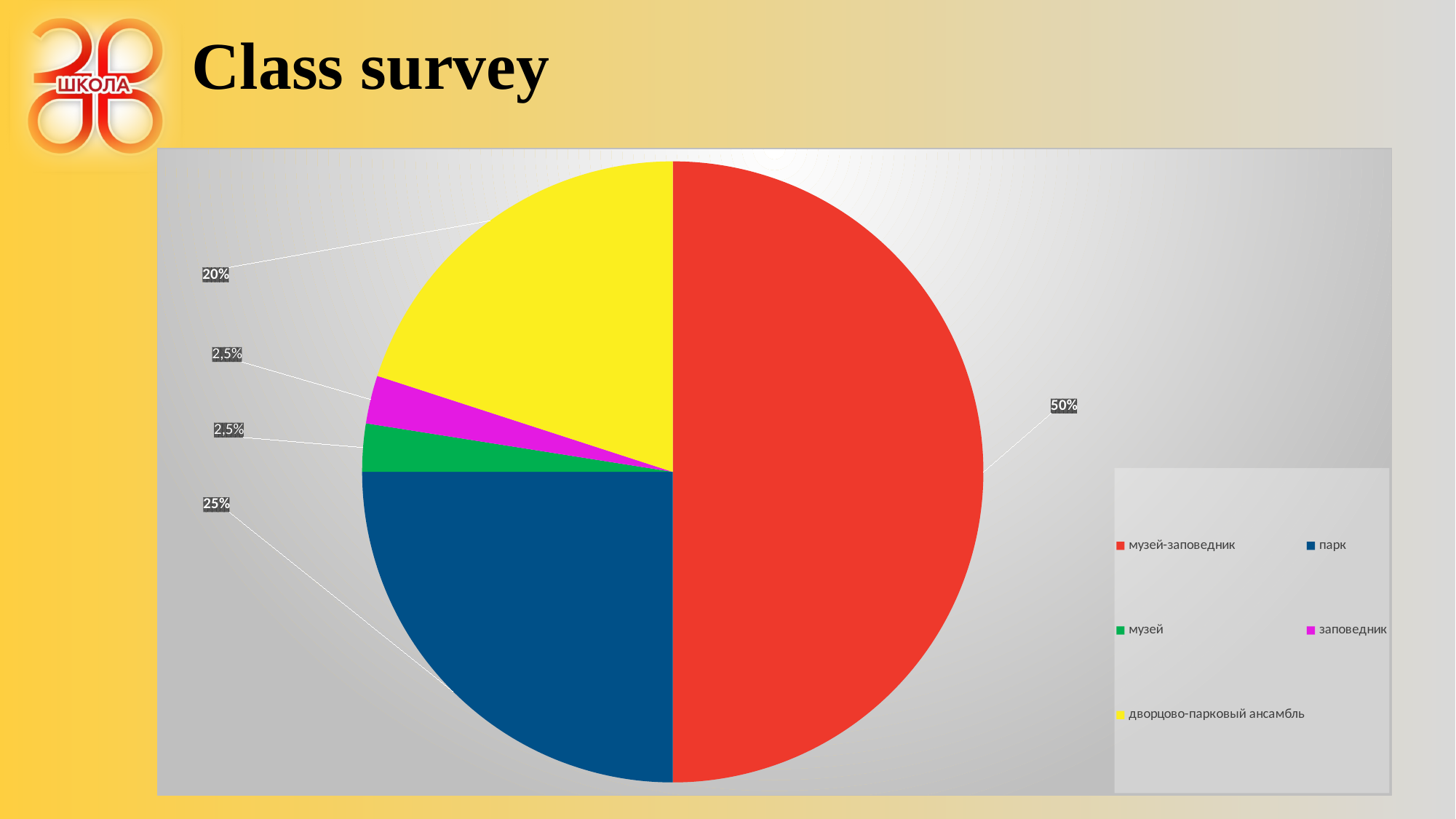
What colour is the slice for дворцово-парковый ансамбль? yellow Which is larger, the share of парк or the share of дворцово-парковый ансамбль? парк What share of the pie does музей-заповедник have? 50% What share of the pie does заповедник have? 2,5% How many categories does the legend list? 5 Which category has the largest slice of the pie? музей-заповедник What share of the pie does парк have? 25% What kind of chart is shown on the slide? pie chart What is the difference between the shares of музей-заповедник and парк? 25% What is the title of the slide containing the chart? Class survey